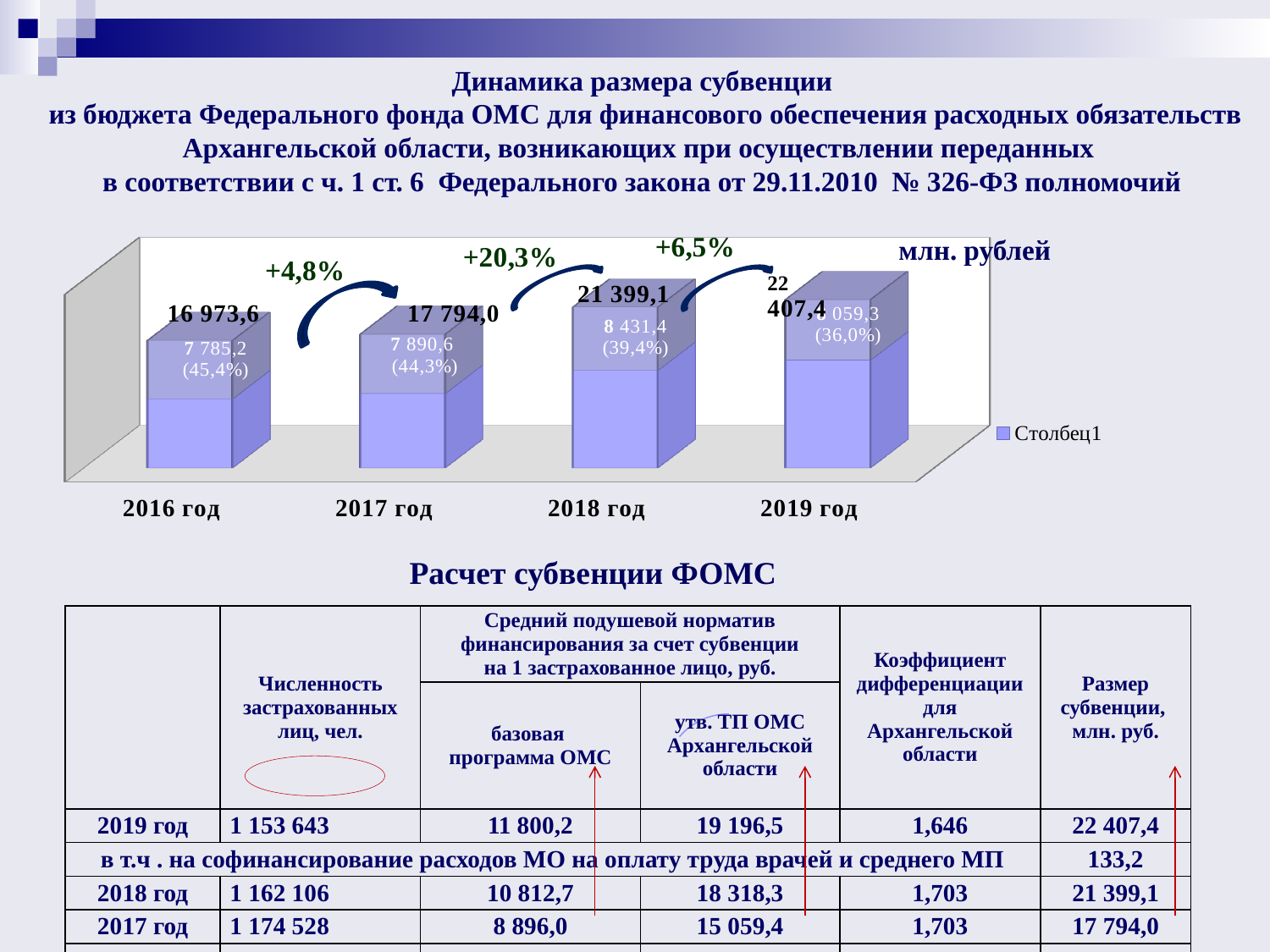
Do the subvention values rise or fall from 2016 год to 2019 год? rise What percentage growth is shown by the arrow between 2017 год and 2018 год? +20,3% What is the total subvention value shown for 2018 год? 21 399,1 What type of chart is shown on the slide? bar chart What is the difference between the 2017 год and 2016 год values? 820,4 How many years (categories) are plotted in the chart? 4 Which year has the highest subvention value in the chart? 2019 год Which is larger, the value for 2017 год or for 2018 год? 2018 год Which year has the lowest subvention value in the chart? 2016 год What is the difference between the 2019 год and 2018 год values? 1 008,3 What is the total subvention value shown for 2016 год? 16 973,6 What is the total subvention value shown for 2019 год? 22 407,4